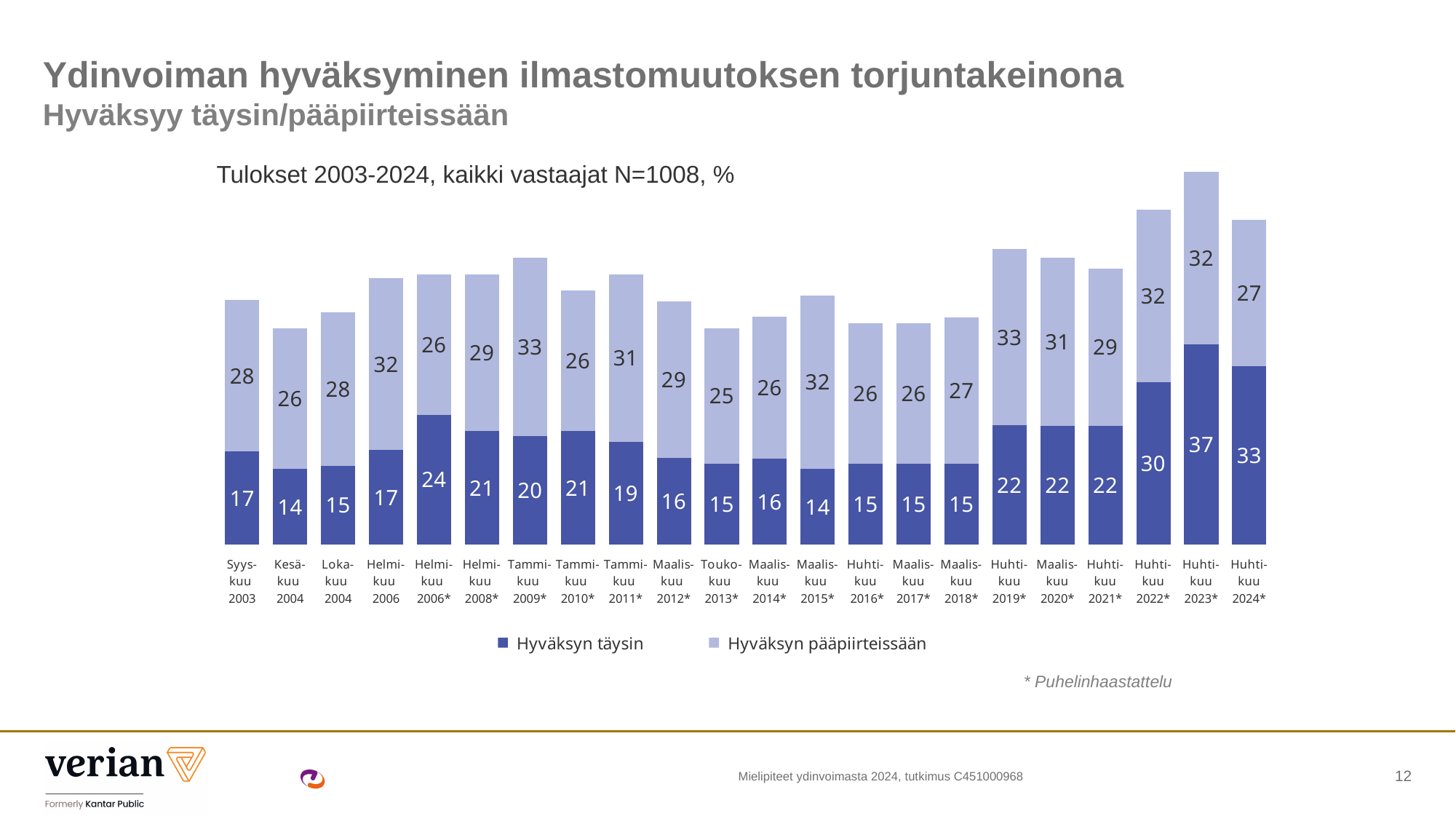
How many time points (bars) are shown in the chart? 22 What is the value of 'Hyväksyn täysin' for Helmikuu 2006*? 24 What type of chart is shown on the slide? Stacked bar chart What is the value of 'Hyväksyn täysin' for Huhtikuu 2023*? 37 Which time point has the lowest value for 'Hyväksyn pääpiirteissään'? Toukokuu 2013* What is the value of 'Hyväksyn pääpiirteissään' for Tammikuu 2009*? 33 What is the total of the stacked bar for Huhtikuu 2024*? 60 Which time point has the highest total stacked bar? Huhtikuu 2023* What is the difference between the 'Hyväksyn täysin' values for Huhtikuu 2023* and Huhtikuu 2022*? 7 How many series does the legend list? 2 Which is larger: 'Hyväksyn täysin' for Huhtikuu 2022* or for Huhtikuu 2021*? Huhtikuu 2022* Which time point has the highest value for 'Hyväksyn täysin'? Huhtikuu 2023*